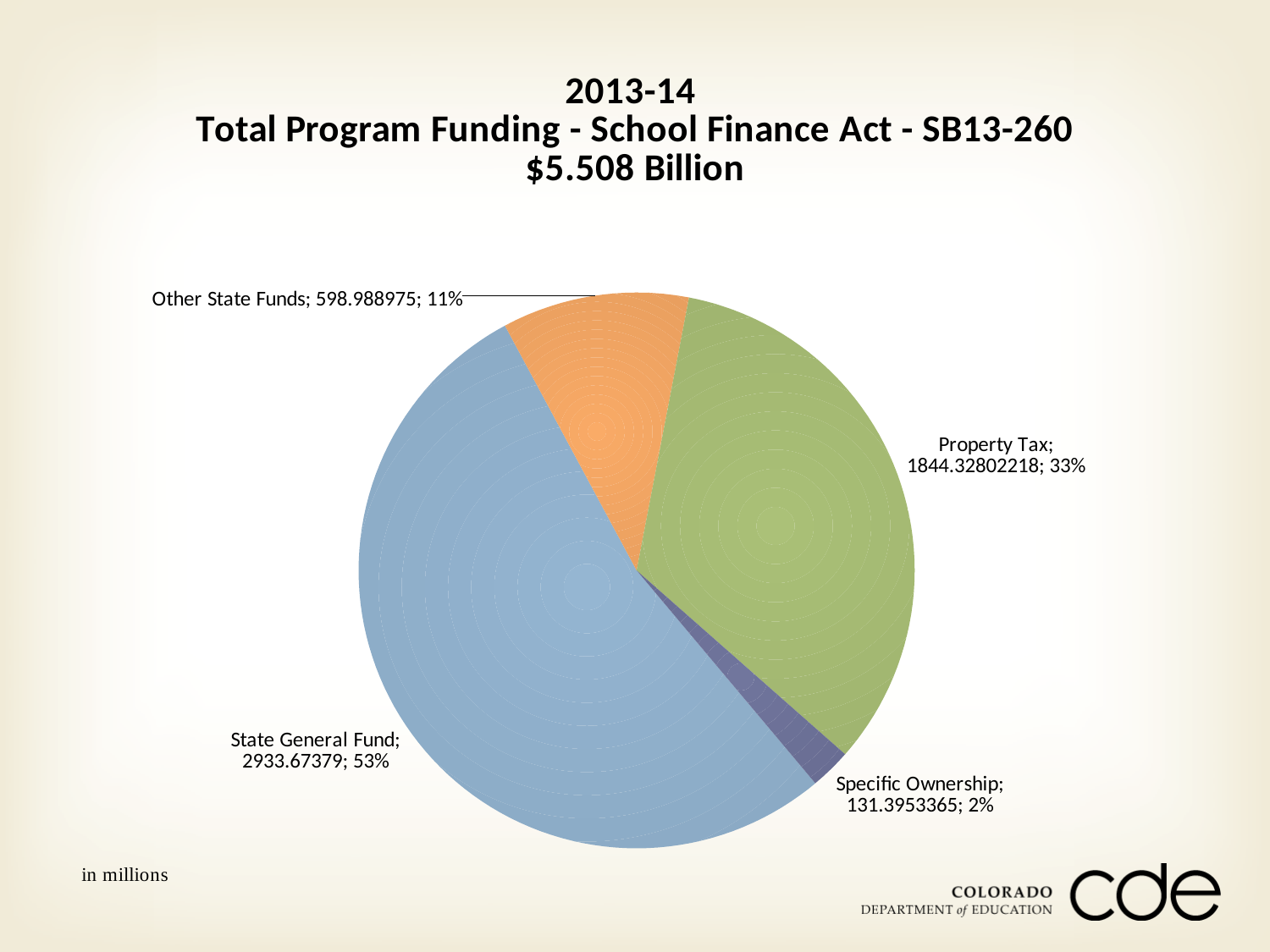
What type of chart is shown on the slide? Pie chart Which category has the largest slice of the pie? State General Fund What share of the pie does Property Tax represent? 33% What is the value for Other State Funds? 598.988975 Which category has the smallest slice of the pie? Specific Ownership What is the value for Specific Ownership? 131.3953365 What is the value for State General Fund? 2933.67379 What share of the pie does Other State Funds represent? 11% Which is larger, Other State Funds or Specific Ownership? Other State Funds What is the value for Property Tax? 1844.32802218 How many categories are shown in the pie chart? 4 What is the difference between the State General Fund value and the Property Tax value? 1089.34576782